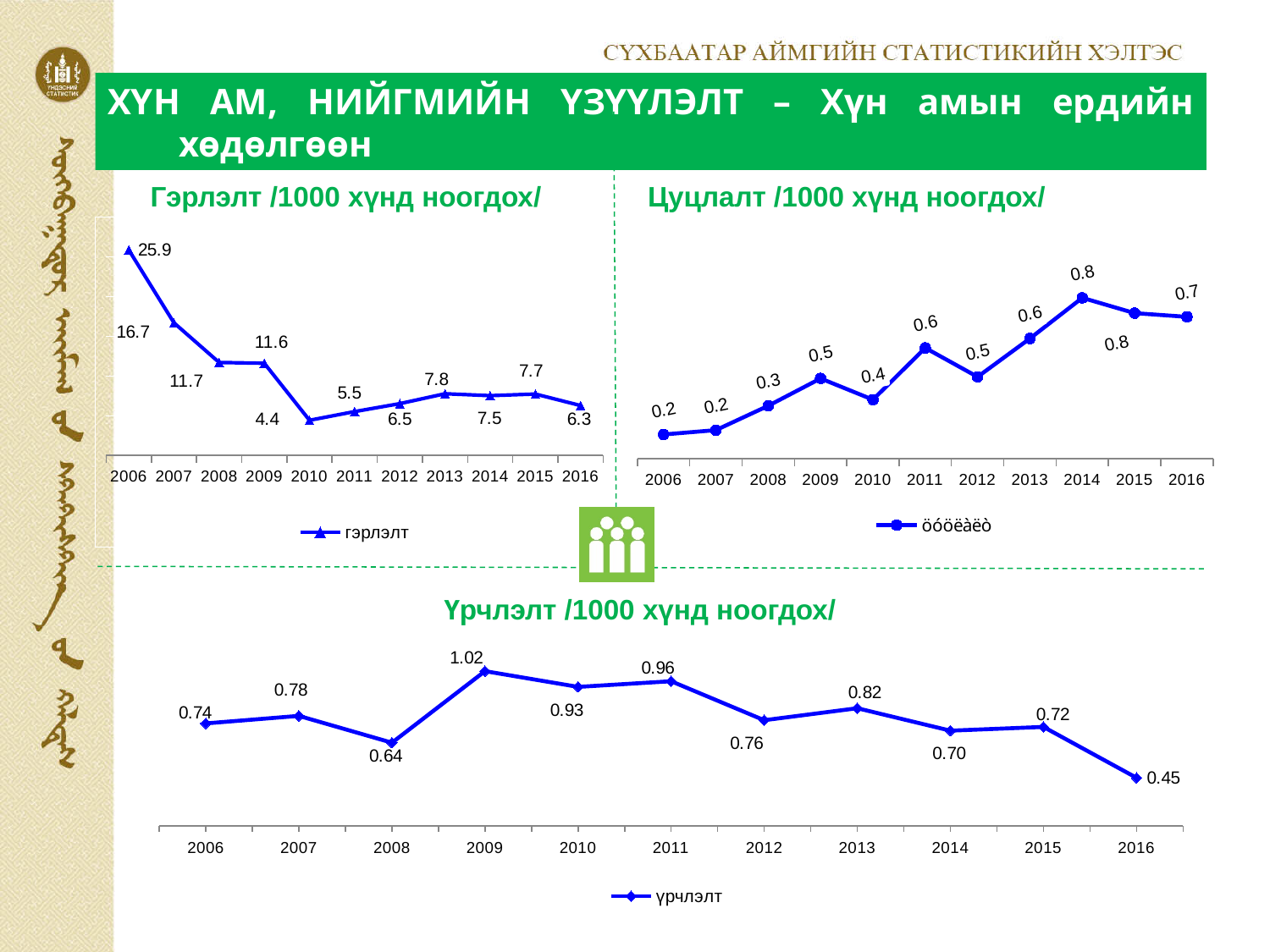
In the chart titled "Үрчлэлт /1000 хүнд ноогдох/", how many series does the legend list? 1 In the chart titled "Цуцлалт /1000 хүнд ноогдох/", do the values generally rise or fall from 2006 to 2016? rise In the chart titled "Цуцлалт /1000 хүнд ноогдох/", which is larger, the value for 2009 or the value for 2010? 2009 In the chart titled "Гэрлэлт /1000 хүнд ноогдох/", what is the value for 2006? 25.9 In the chart titled "Үрчлэлт /1000 хүнд ноогдох/", which year has the highest value? 2009 In the chart titled "Гэрлэлт /1000 хүнд ноогдох/", what is the difference between the values for 2006 and 2016? 19.6 In the chart titled "Гэрлэлт /1000 хүнд ноогдох/", which year has the lowest value? 2010 In the chart titled "Үрчлэлт /1000 хүнд ноогдох/", what is the difference between the values for 2009 and 2008? 0.38 In the chart titled "Гэрлэлт /1000 хүнд ноогдох/", how many years are plotted on the x axis? 11 In the chart titled "Үрчлэлт /1000 хүнд ноогдох/", what is the value for 2016? 0.45 In the chart titled "Цуцлалт /1000 хүнд ноогдох/", what is the value for 2011? 0.6 What kind of chart is the chart titled "Цуцлалт /1000 хүнд ноогдох/"? line chart